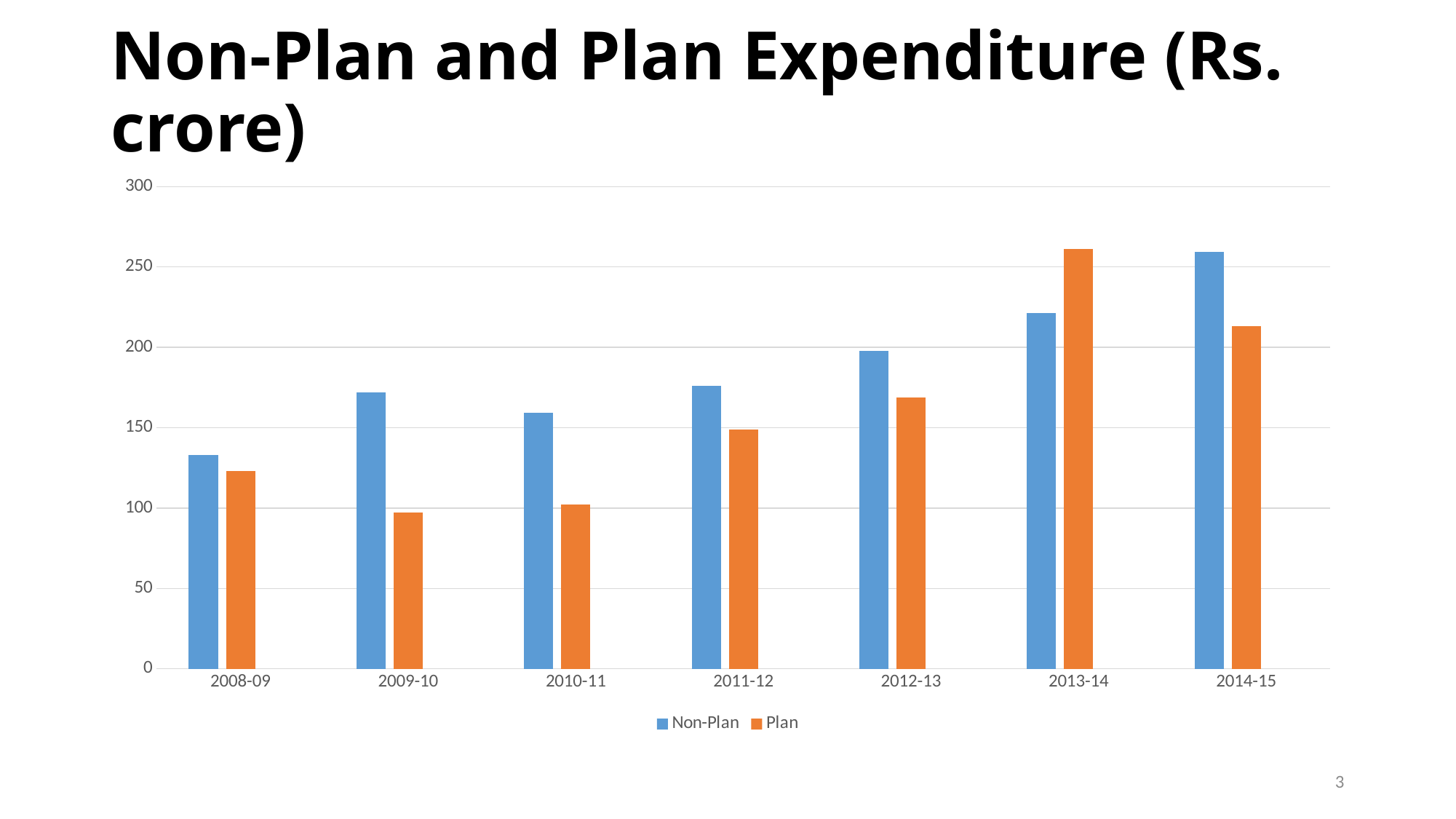
In 2009-10, which is larger, Non-Plan or Plan expenditure? Non-Plan Is the Non-Plan value for 2013-14 greater or less than 200? greater How many series does the legend list? 2 In which year is the Non-Plan expenditure lowest? 2008-09 What kind of chart is shown on the slide? bar chart Is the Plan value for 2012-13 greater or less than 150? greater Is the Non-Plan value for 2014-15 greater or less than 250? greater Overall, do the Non-Plan values rise or fall from 2008-09 to 2014-15? rise How many years are shown on the x axis? 7 In which year is the Plan expenditure highest? 2013-14 In 2013-14, which is larger, Non-Plan or Plan expenditure? Plan In which year is the Non-Plan expenditure highest? 2014-15